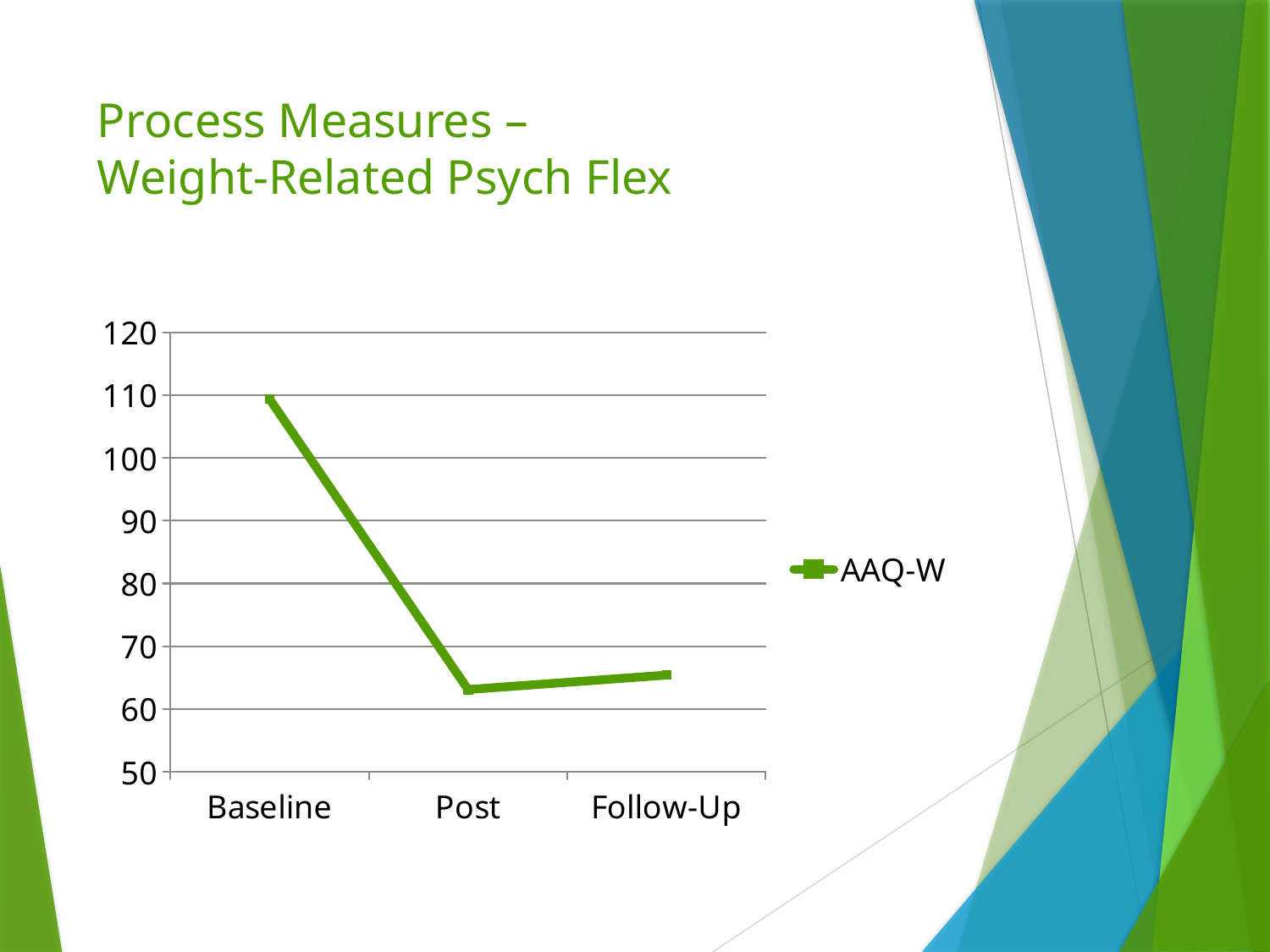
How many series does the legend list? 1 Is the AAQ-W value at Follow-Up greater or less than 70? less Is the AAQ-W value at Post greater or less than 60? greater What kind of chart is shown on the slide? line chart What is the title of the slide containing the chart? Process Measures – Weight-Related Psych Flex Does the AAQ-W value rise or fall from Baseline to Post? fall Is the AAQ-W value at Post greater or less than 70? less Which has the larger AAQ-W value, Baseline or Post? Baseline At which time point is the AAQ-W value highest? Baseline How many time points are plotted on the x axis? 3 What is the name of the series shown in the legend? AAQ-W